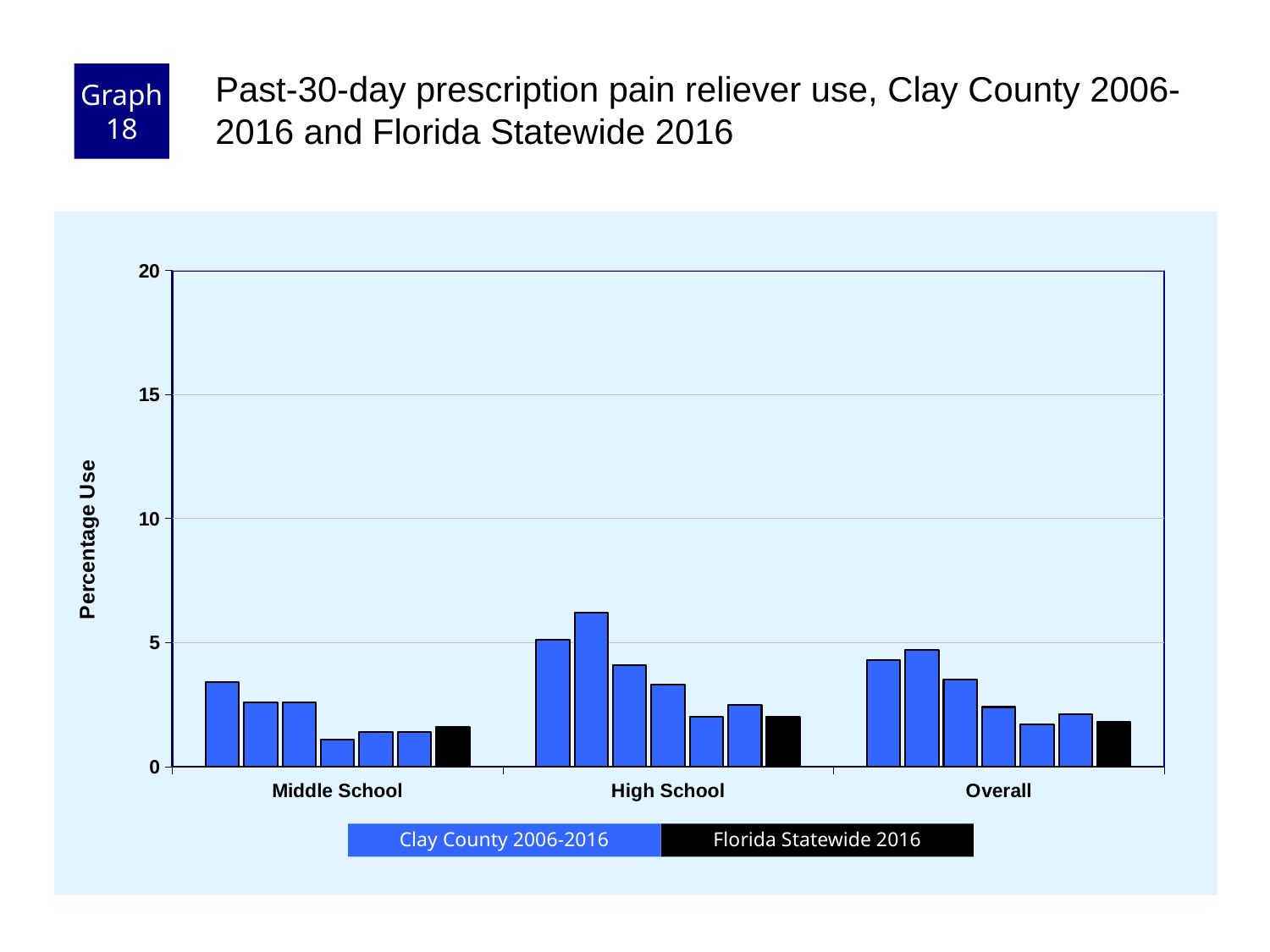
How many categories are shown on the x axis of the chart? 3 What kind of chart is shown on the slide? bar chart Which series is shown in black in the chart's legend? Florida Statewide 2016 How many series does the chart's legend list? 2 Is the tallest Clay County 2006-2016 bar for High School greater or less than 5? greater Which is larger: the Florida Statewide 2016 bar for High School or the tallest Clay County 2006-2016 bar for High School? Clay County 2006-2016 Is the tallest Clay County 2006-2016 bar for Middle School greater or less than 5? less Is the Florida Statewide 2016 value for High School greater or less than 5? less Which is larger: the tallest Clay County 2006-2016 bar for High School or the tallest Clay County 2006-2016 bar for Middle School? High School What is the label on the y axis of the chart? Percentage Use Which category has the tallest bar in the chart? High School